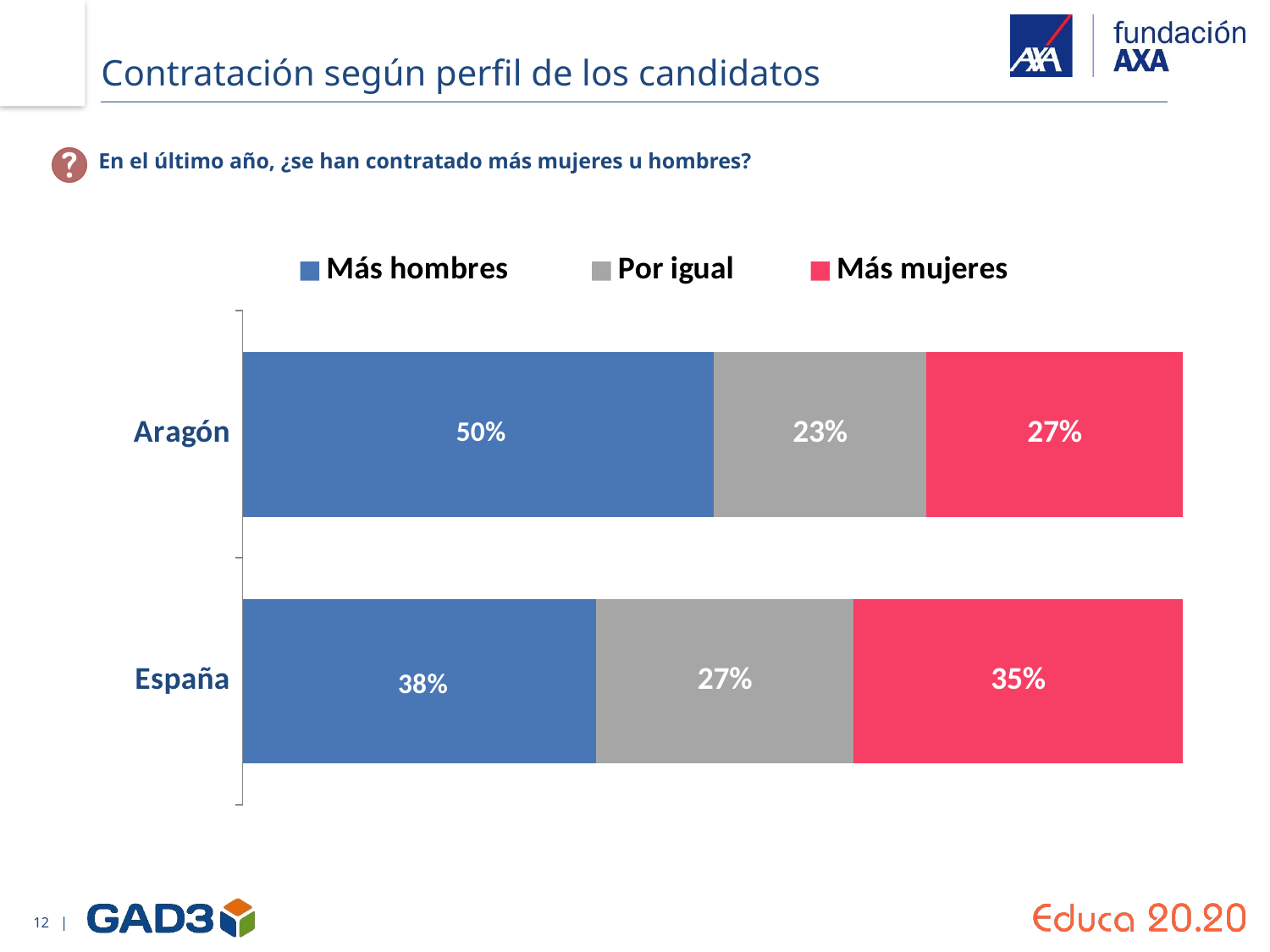
What is the difference between the "Más hombres" values for Aragón and España? 12 percentage points What is the value for "Por igual" in España? 27% Which series has the lowest value in Aragón? Por igual How many series does the legend list? 3 What is the value for "Más hombres" in Aragón? 50% What is the value for "Más mujeres" in Aragón? 27% How many categories are shown on the chart? 2 Which category has the higher value for "Más mujeres", Aragón or España? España What kind of chart is shown on the slide? Stacked bar chart What is the value for "Más hombres" in España? 38% Which category has the higher value for "Más hombres", Aragón or España? Aragón What is the difference between the "Más mujeres" values for España and Aragón? 8 percentage points